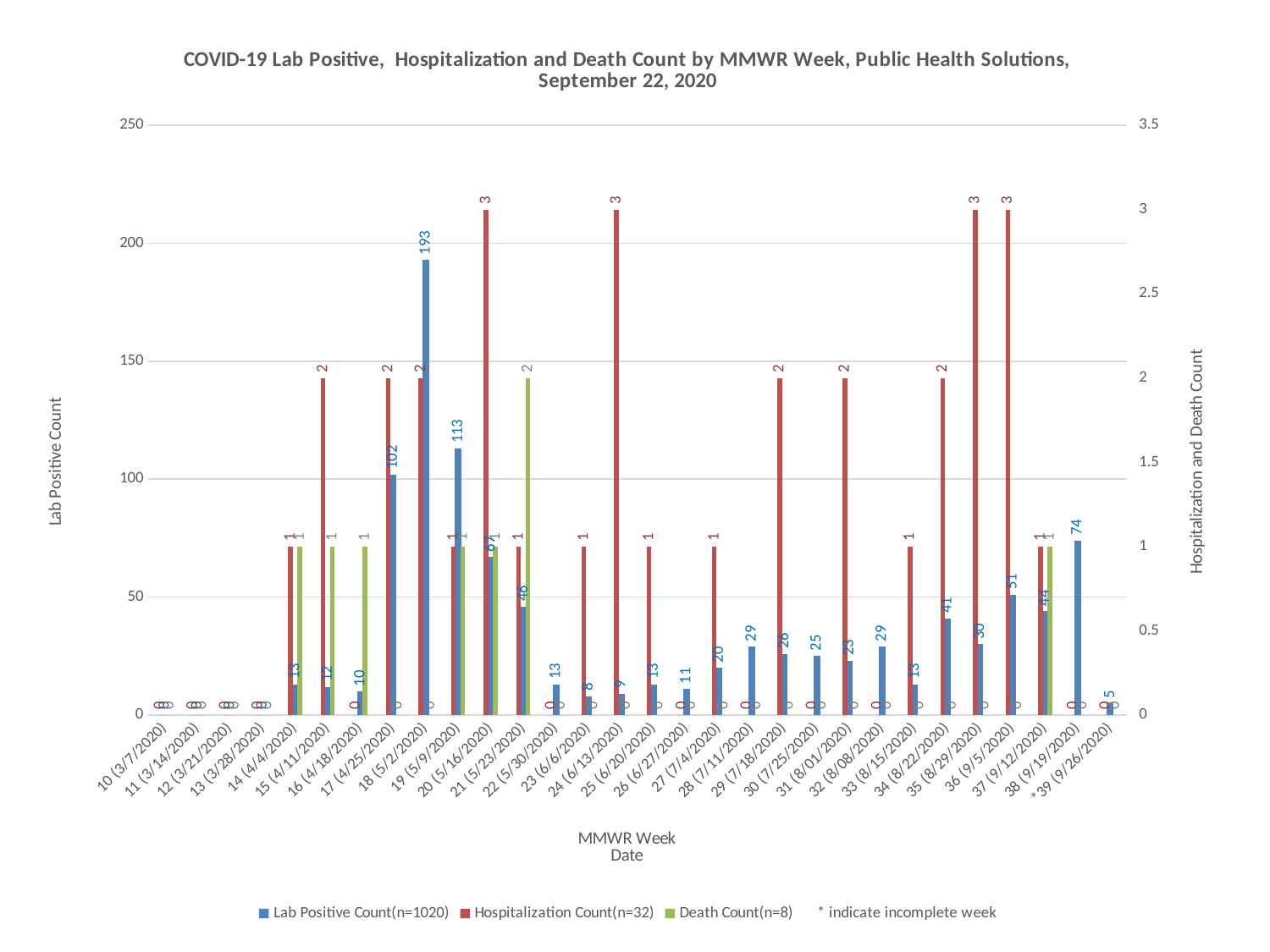
Which is larger, the Lab Positive Count for week 36 (9/5/2020) or for week 38 (9/19/2020)? week 38 (9/19/2020) How many MMWR weeks are shown on the x axis? 30 What is the difference between the Lab Positive Count for week 18 (5/2/2020) and week 19 (5/9/2020)? 80 What is the Hospitalization Count for MMWR week 20 (5/16/2020)? 3 Is the Lab Positive Count for week 17 (4/25/2020) greater or less than 100? greater What kind of chart is shown on the slide? bar chart How many series does the legend list? 3 What is the Death Count for MMWR week 21 (5/23/2020)? 2 Which MMWR week has the highest Death Count? 21 (5/23/2020) What is the Lab Positive Count for MMWR week 18 (5/2/2020)? 193 What does the asterisk (*) on the x axis label indicate, according to the legend note? incomplete week Which MMWR week has the highest Lab Positive Count? 18 (5/2/2020)